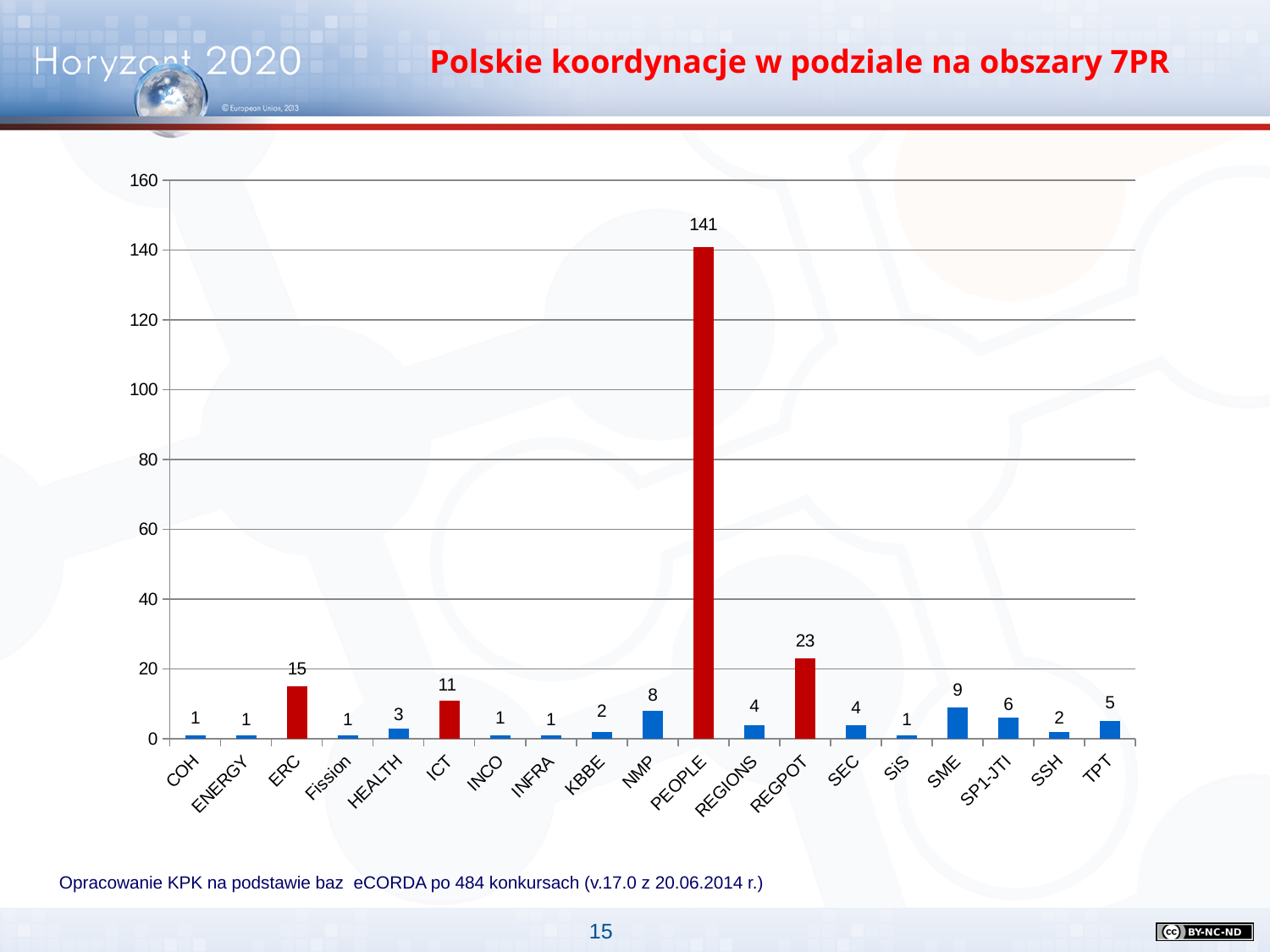
Which categories are shown with red bars? ERC, ICT, PEOPLE, REGPOT Is the value for PEOPLE greater or less than 140? greater What is the difference between the values for ERC and ICT? 4 What is the difference between the values for PEOPLE and REGPOT? 118 What kind of chart is shown on the slide? bar chart Which category has the highest value? PEOPLE What is the value for SME? 9 What is the value for REGPOT? 23 What is the value for ERC? 15 Which is larger, the value for NMP or the value for SP1-JTI? NMP How many categories are shown on the x axis? 19 What is the value for PEOPLE? 141